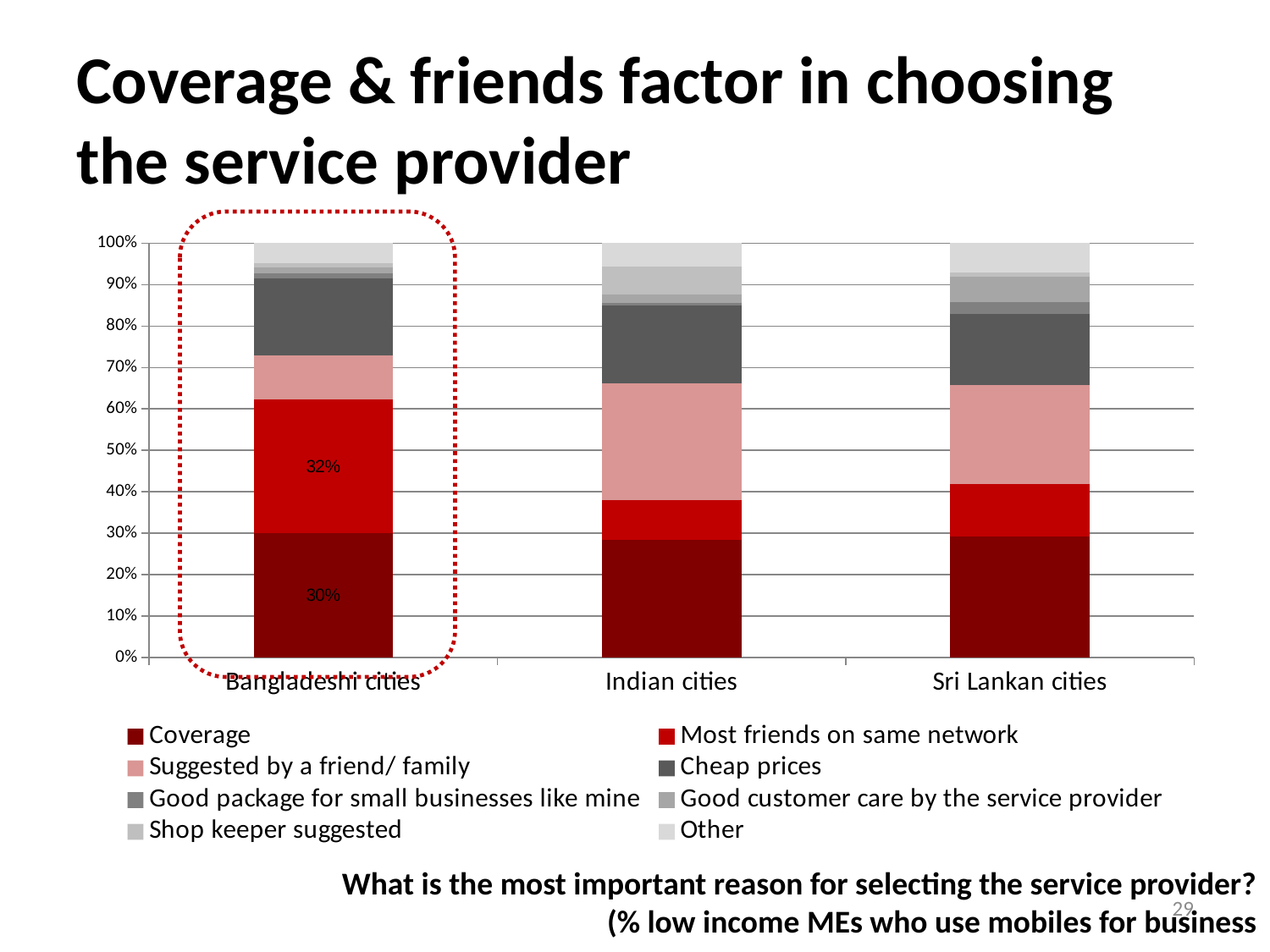
How many city groups are shown on the x axis? 3 What is the value for Coverage in Bangladeshi cities? 30% In Bangladeshi cities, which is larger: Coverage or Most friends on same network? Most friends on same network Which city group has the largest Most friends on same network segment? Bangladeshi cities How many series does the legend list? 8 In Bangladeshi cities, what is the difference between the Most friends on same network value and the Coverage value? 2% What kind of chart is shown on the slide? Stacked bar chart Is the Suggested by a friend/ family value for Indian cities greater or less than 20%? greater Is the Coverage value for Indian cities greater or less than 30%? less Which has a larger Suggested by a friend/ family segment: Indian cities or Bangladeshi cities? Indian cities What is the value for Most friends on same network in Bangladeshi cities? 32% Which city group is highlighted with a red dotted outline? Bangladeshi cities